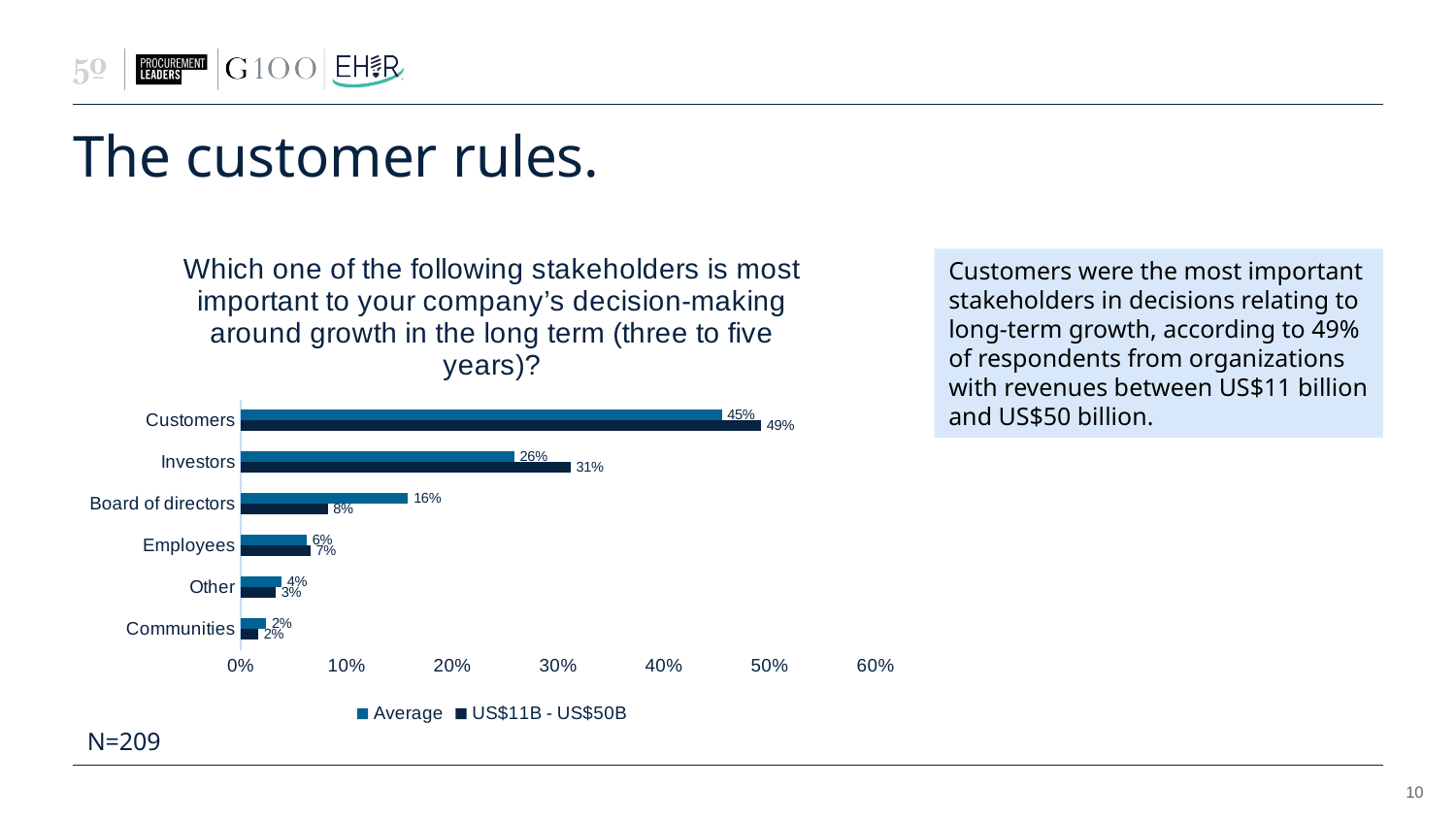
What is the US$11B - US$50B value for Board of directors? 8% What kind of chart is shown on the slide? Bar chart What is the Average value for Customers? 45% Which category has the highest Average value? Customers For Board of directors, which series has the larger value: Average or US$11B - US$50B? Average What is the US$11B - US$50B value for Investors? 31% What is the difference between the US$11B - US$50B value and the Average value for Customers? 4% How many stakeholder categories are shown on the chart? 6 What is the sample size (N) stated on the slide? N=209 Is the Average value for Investors greater or less than 20%? greater Which category has the lowest US$11B - US$50B value? Communities How many series does the legend list? 2